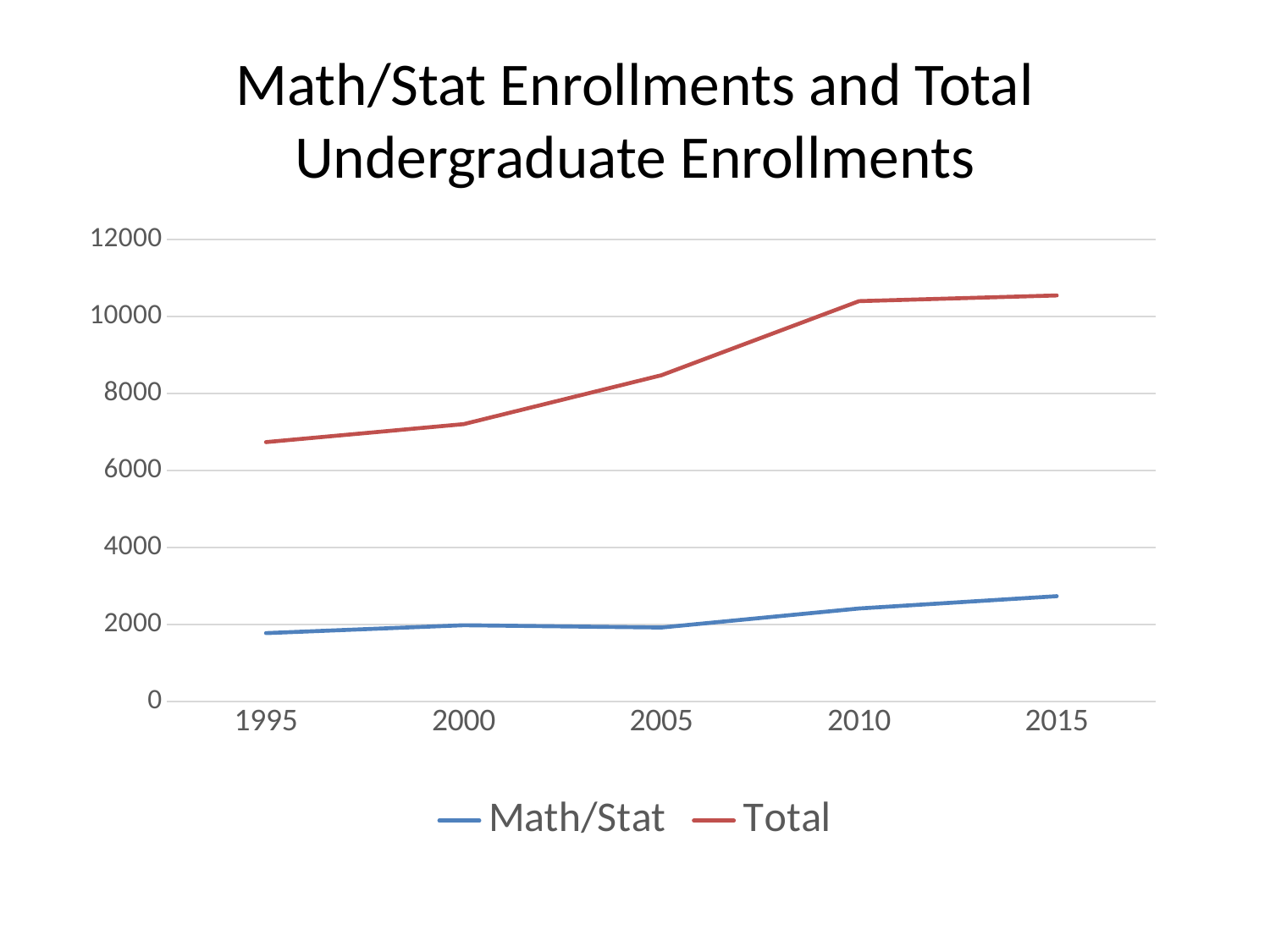
Which series has the larger value in 2005, Math/Stat or Total? Total Is the Total value for 2000 greater or less than 8000? less What kind of chart is shown on the slide? line chart In which year is the Total series at its lowest? 1995 Is the Math/Stat value for 2015 greater or less than 4000? less How many years are plotted along the x axis? 5 Is the Math/Stat value for 2015 greater or less than 2000? greater How many series does the legend list? 2 Does the Total series rise or fall from 1995 to 2015? rise In which year is the Math/Stat series at its highest? 2015